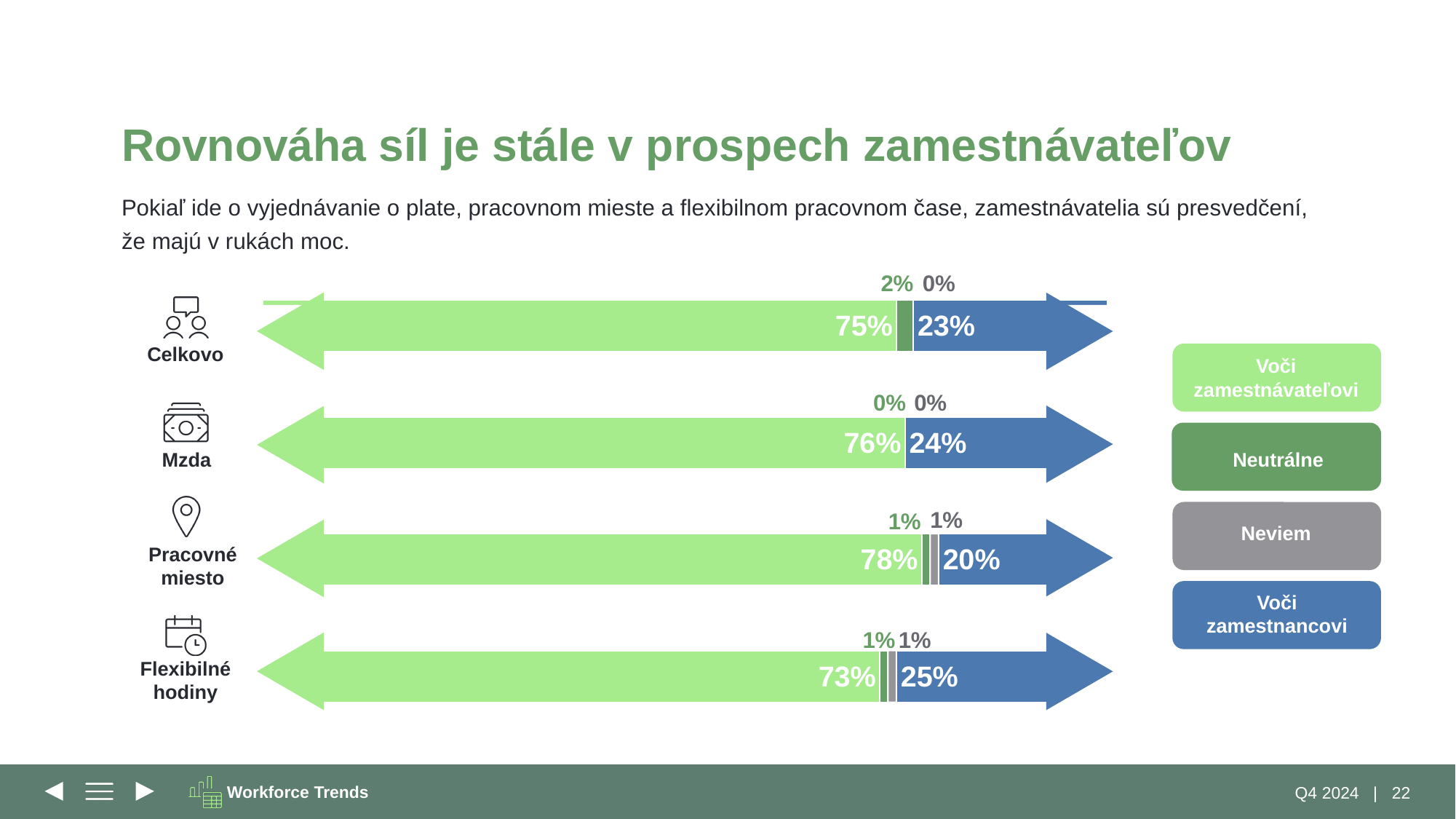
How many categories are shown in the chart? 4 What is the "Neutrálne" value for the Celkovo row? 2% What is the "Neviem" value for the Pracovné miesto row? 1% What kind of chart is shown on the slide? Stacked horizontal bar chart What is the value for "Voči zamestnancovi" in the Mzda row? 24% Which category has the highest "Voči zamestnávateľovi" value? Pracovné miesto What is the value for "Voči zamestnávateľovi" in the Celkovo row? 75% Which category has the lowest "Voči zamestnávateľovi" value? Flexibilné hodiny What is the difference between the "Voči zamestnávateľovi" and "Voči zamestnancovi" values in the Flexibilné hodiny row? 48% Which category has the highest "Voči zamestnancovi" value? Flexibilné hodiny Is the "Voči zamestnancovi" value larger for Mzda or for Pracovné miesto? Mzda How many series does the legend list? 4